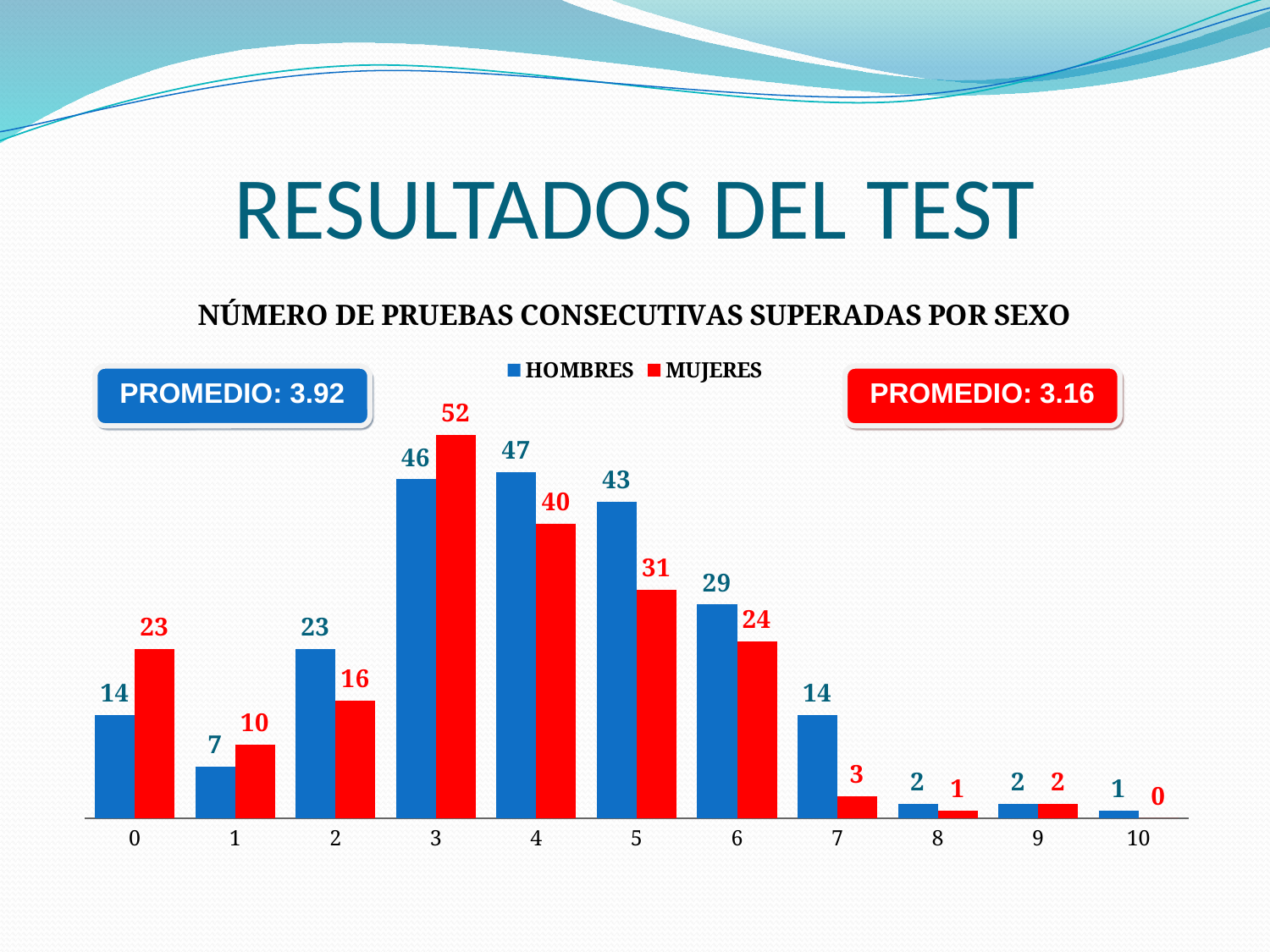
How many series does the legend list? 2 How many categories are shown on the x axis? 11 What kind of chart is shown on the slide? Bar chart Do the values for HOMBRES rise or fall from category 4 to category 10? Fall What is the difference between HOMBRES and MUJERES at category 5? 12 What is the value for MUJERES at category 3? 52 What is the value for HOMBRES at category 4? 47 At category 0, which series has the larger value, HOMBRES or MUJERES? MUJERES Which category has the highest value for HOMBRES? 4 What is the title of the chart? NÚMERO DE PRUEBAS CONSECUTIVAS SUPERADAS POR SEXO What is the value for MUJERES at category 10? 0 Which category has the lowest value for MUJERES? 10